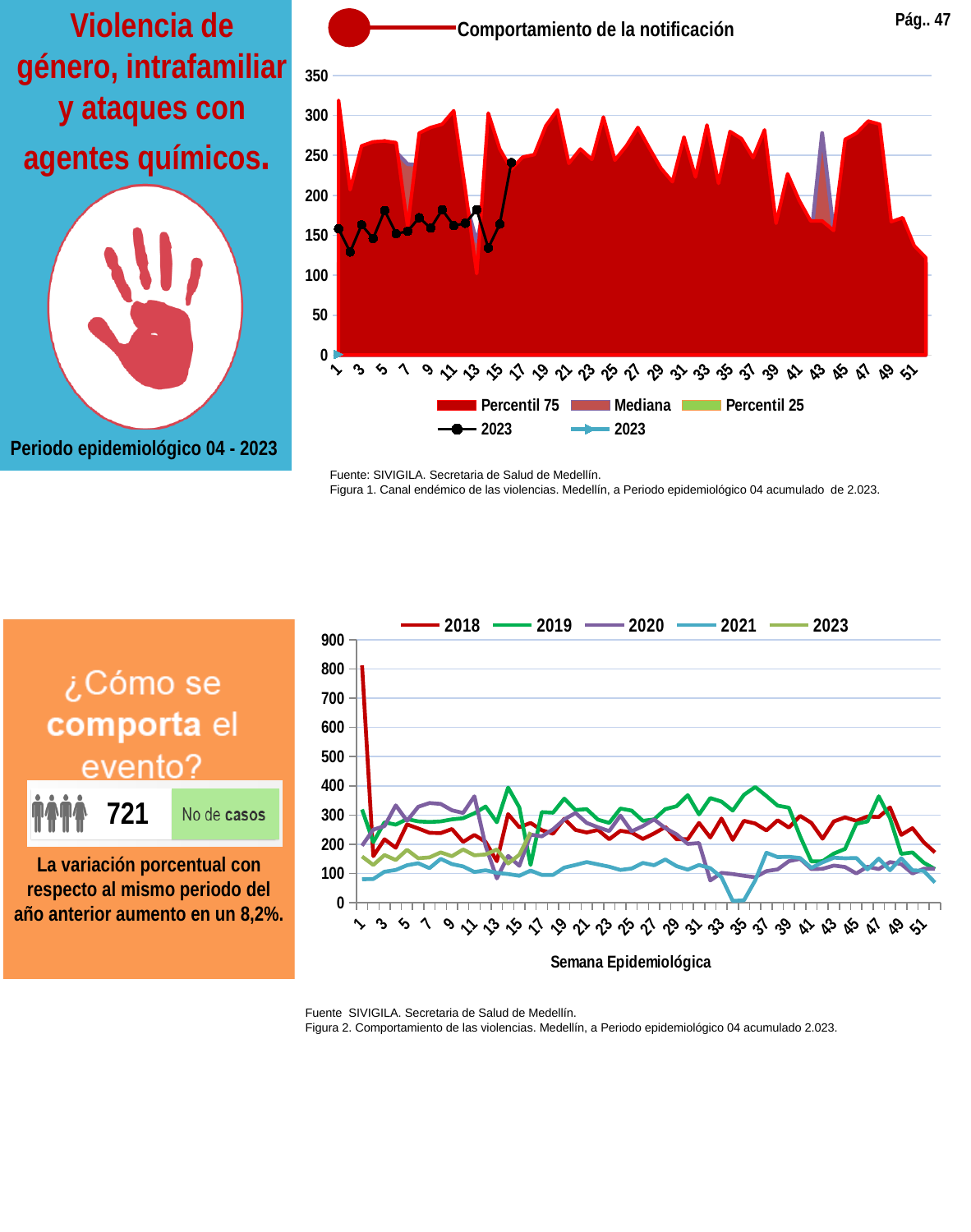
In the bottom chart, is the 2021 value at week 35 greater or less than 100? less In the bottom chart, is the 2019 value at week 47 greater or less than 300? greater In the bottom chart, what is the x-axis title? Semana Epidemiológica How many series does the legend of the bottom chart list? 5 In the top chart, is the 2023 value at week 16 greater or less than 200? greater How many entries does the legend of the top chart list? 5 What kind of chart is the bottom chart (Figura 2)? line chart What is the title of the top chart? Comportamiento de la notificación In the bottom chart, which series has the higher value at week 1, 2018 or 2021? 2018